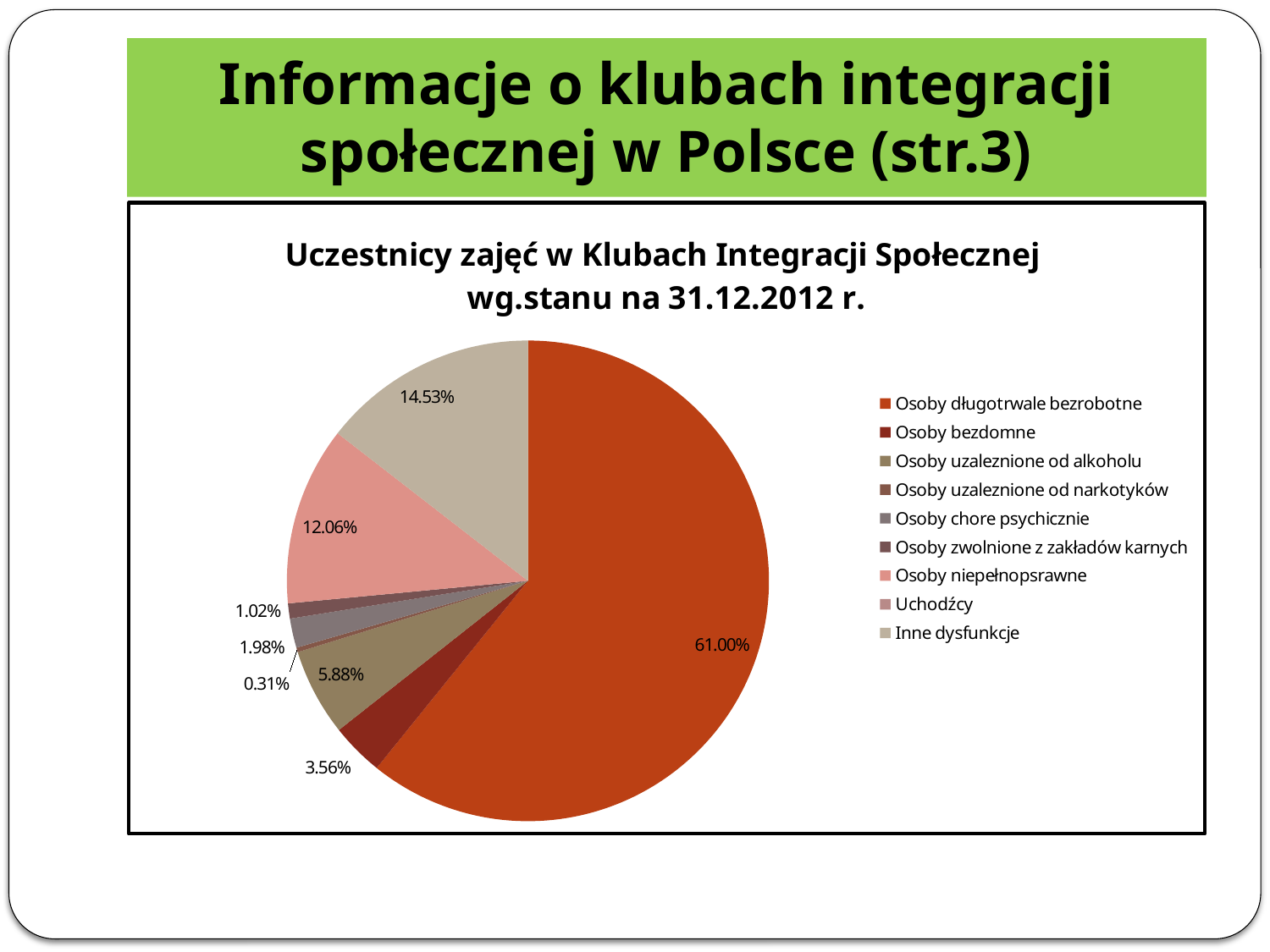
What type of chart is shown on the slide? pie chart Which is larger, 'Inne dysfunkcje' or 'Osoby niepełnopsrawne'? Inne dysfunkcje What is the value for 'Osoby uzaleznione od alkoholu'? 5.88% What is the value for 'Inne dysfunkcje'? 14.53% What is the difference between 'Inne dysfunkcje' and 'Osoby niepełnopsrawne'? 2.47% How many categories does the legend list? 9 What is the value for 'Osoby bezdomne'? 3.56% What share of the pie is 'Osoby długotrwale bezrobotne'? 61.00% What is the title of the chart? Uczestnicy zajęć w Klubach Integracji Społecznej wg.stanu na 31.12.2012 r. What is the value for 'Osoby niepełnopsrawne'? 12.06% Which category has the largest share of the pie? Osoby długotrwale bezrobotne What is the value for 'Osoby chore psychicznie'? 1.98%